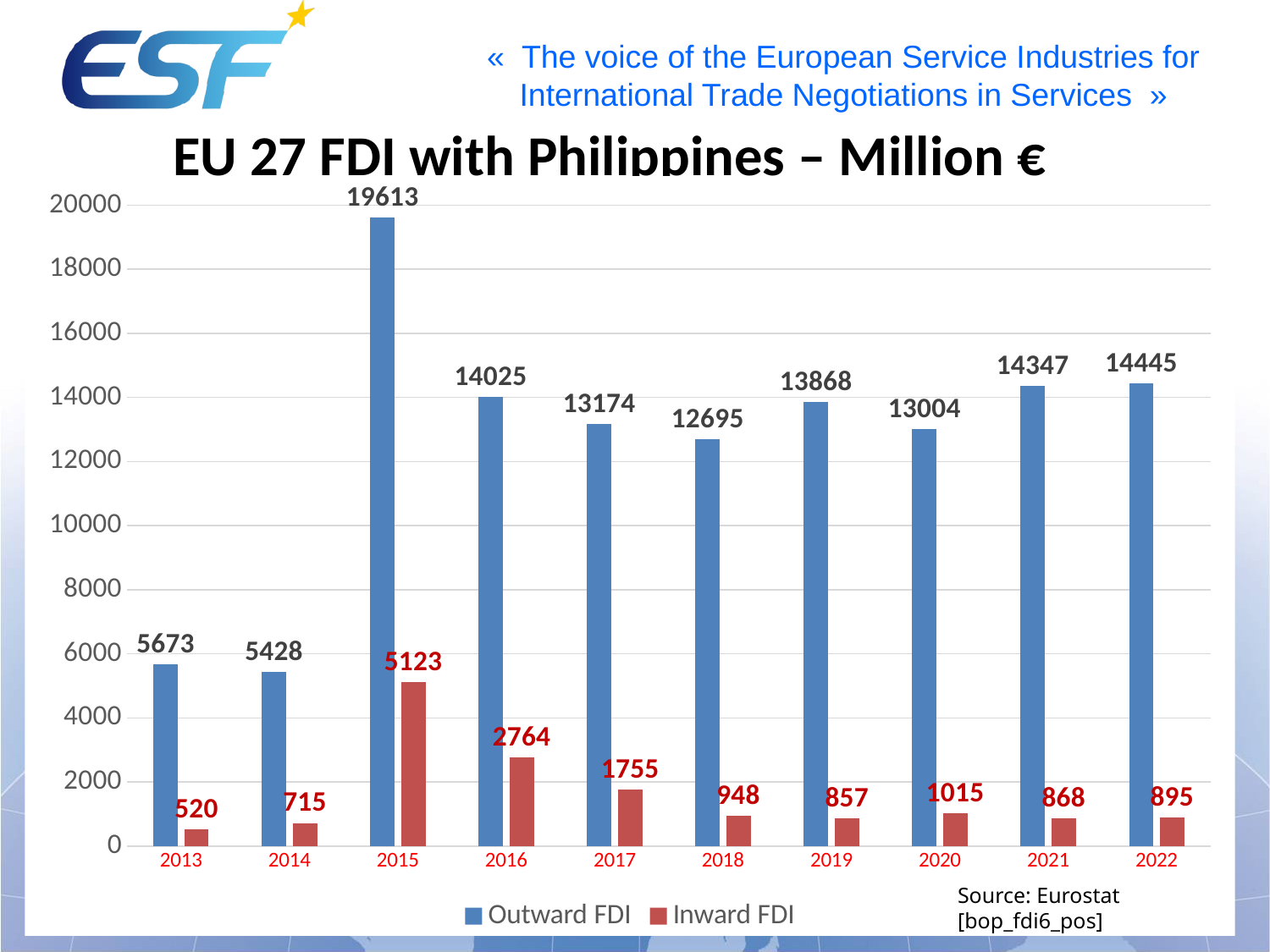
What is the Inward FDI value for 2016? 2764 What is the source cited for the chart data? Eurostat [bop_fdi6_pos] What is the Outward FDI value for 2015? 19613 Which is larger, the Outward FDI in 2021 or in 2022? 2022 How many years are shown on the x axis? 10 How many series does the legend list? 2 What is the difference between Outward FDI and Inward FDI in 2015? 14490 Does the Inward FDI rise or fall from 2015 to 2019? Fall What kind of chart is shown on the slide? Bar chart What is the Inward FDI value for 2013? 520 Which year has the highest Outward FDI? 2015 Which year has the lowest Inward FDI? 2013